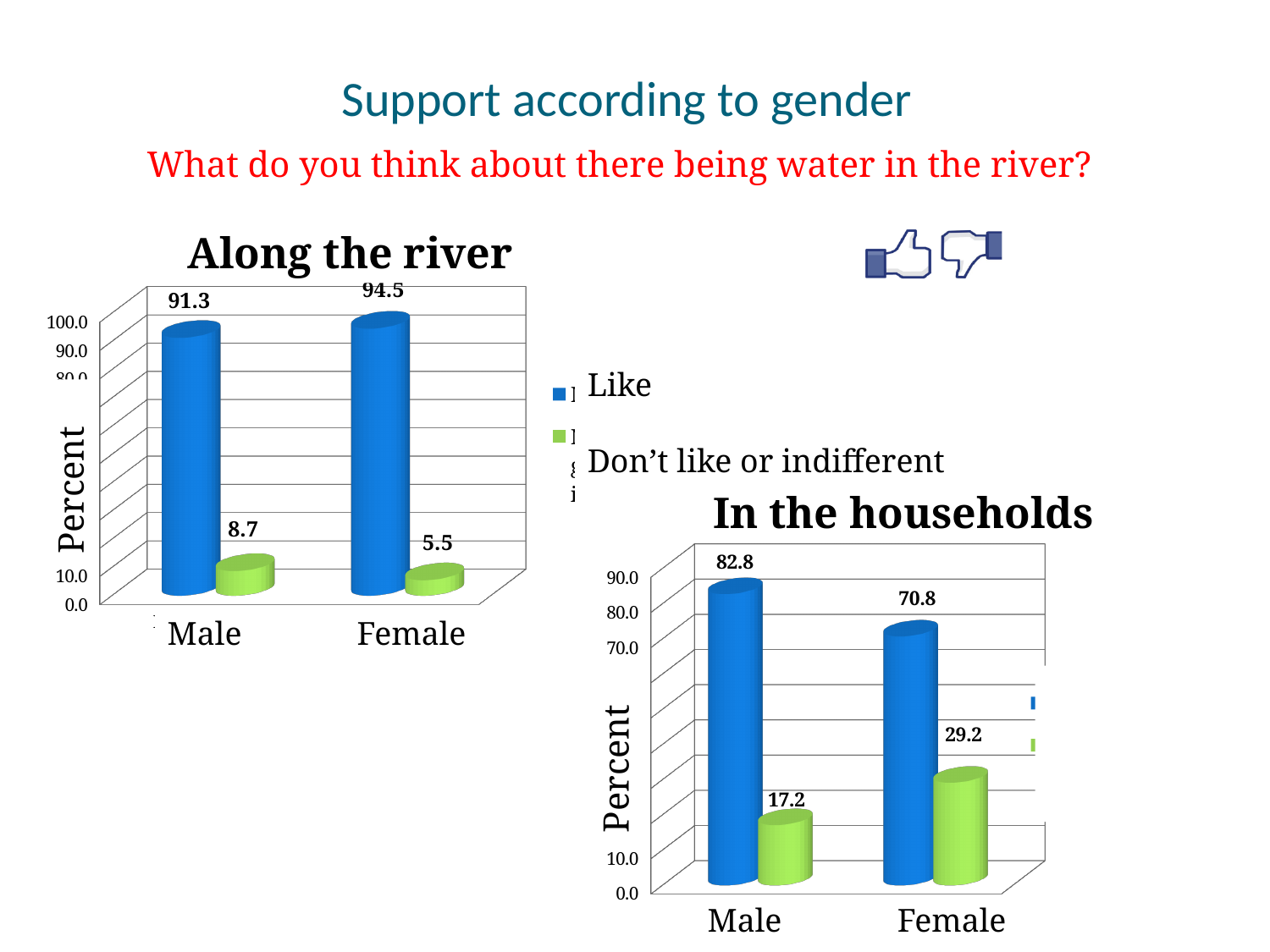
In the 'Along the river' chart, which gender has the higher value for Like? Female In the 'In the households' chart, which gender has the lower value for Like? Female In the 'In the households' chart, is the value for Like among males greater or less than 80.0? greater In the 'Along the river' chart, what is the value for Like among males? 91.3 In the 'In the households' chart, what is the value for Like among females? 70.8 What type of chart is the 'In the households' chart? Bar chart In the 'Along the river' chart, what is the difference between the Like values for females and males? 3.2 Is the Like value for males higher in the 'Along the river' chart or in the 'In the households' chart? Along the river In the 'In the households' chart, what is the difference between the Don't like or indifferent values for females and males? 12.0 In the 'In the households' chart, what is the value for Don't like or indifferent among males? 17.2 In the 'Along the river' chart, what is the value for Don't like or indifferent among females? 5.5 How many series does the legend list for the charts on this slide? 2